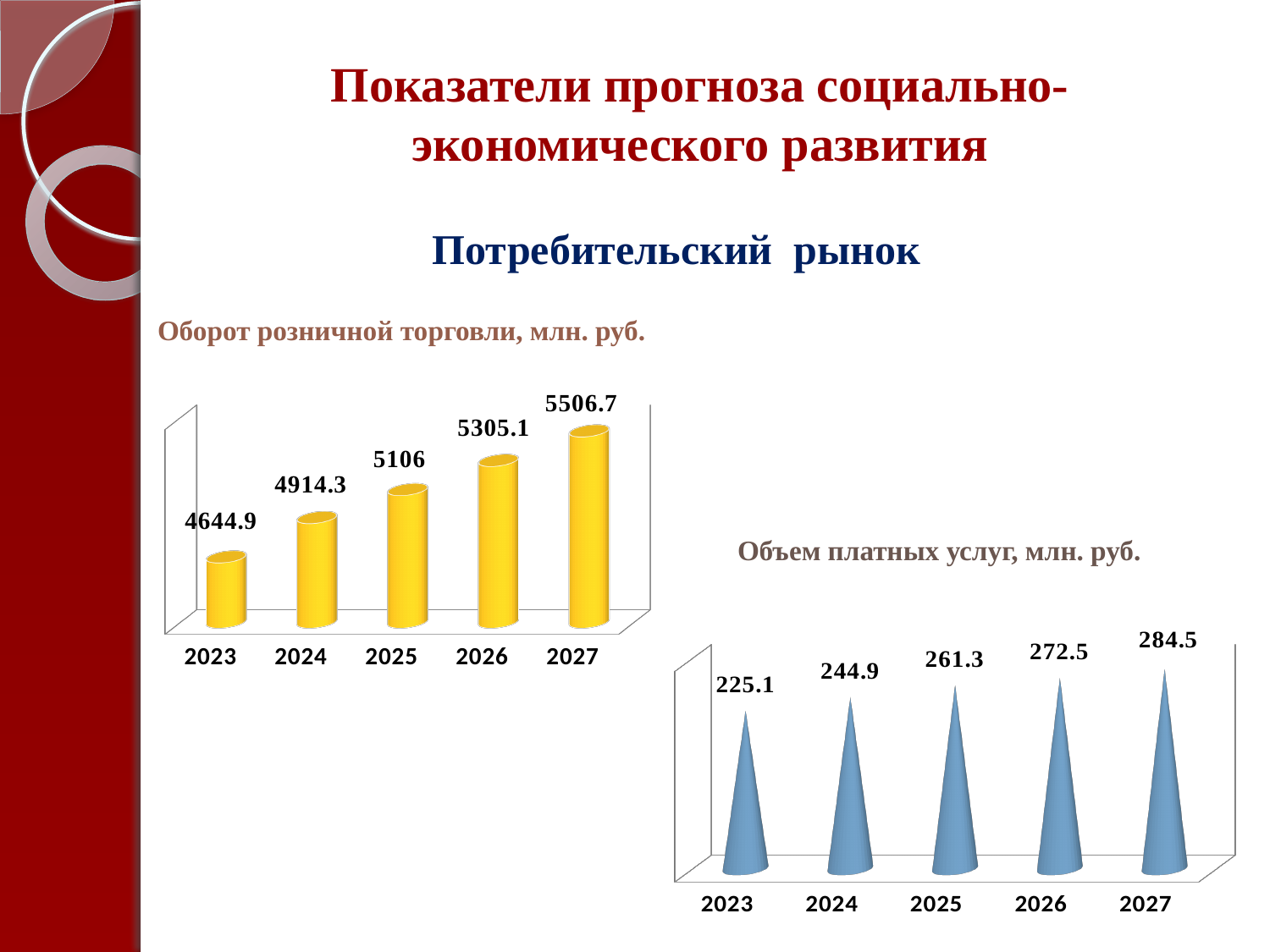
What colour are the bars in the chart 'Оборот розничной торговли, млн. руб.'? Yellow What kind of chart is 'Объем платных услуг, млн. руб.'? Bar chart In the chart 'Объем платных услуг, млн. руб.', which year has the highest value? 2027 In the chart 'Оборот розничной торговли, млн. руб.', what is the value for 2025? 5106 In the chart 'Объем платных услуг, млн. руб.', which is larger: the value for 2025 or the value for 2024? 2025 How many years are shown in the chart 'Оборот розничной торговли, млн. руб.'? 5 In the chart 'Объем платных услуг, млн. руб.', what is the difference between the values for 2024 and 2023? 19.8 In the chart 'Оборот розничной торговли, млн. руб.', which year has the lowest value? 2023 In the chart 'Оборот розничной торговли, млн. руб.', what is the difference between the values for 2027 and 2026? 201.6 In the chart 'Оборот розничной торговли, млн. руб.', do the values rise or fall from 2023 to 2027? Rise In the chart 'Оборот розничной торговли, млн. руб.', what is the value for 2023? 4644.9 In the chart 'Объем платных услуг, млн. руб.', what is the value for 2026? 272.5